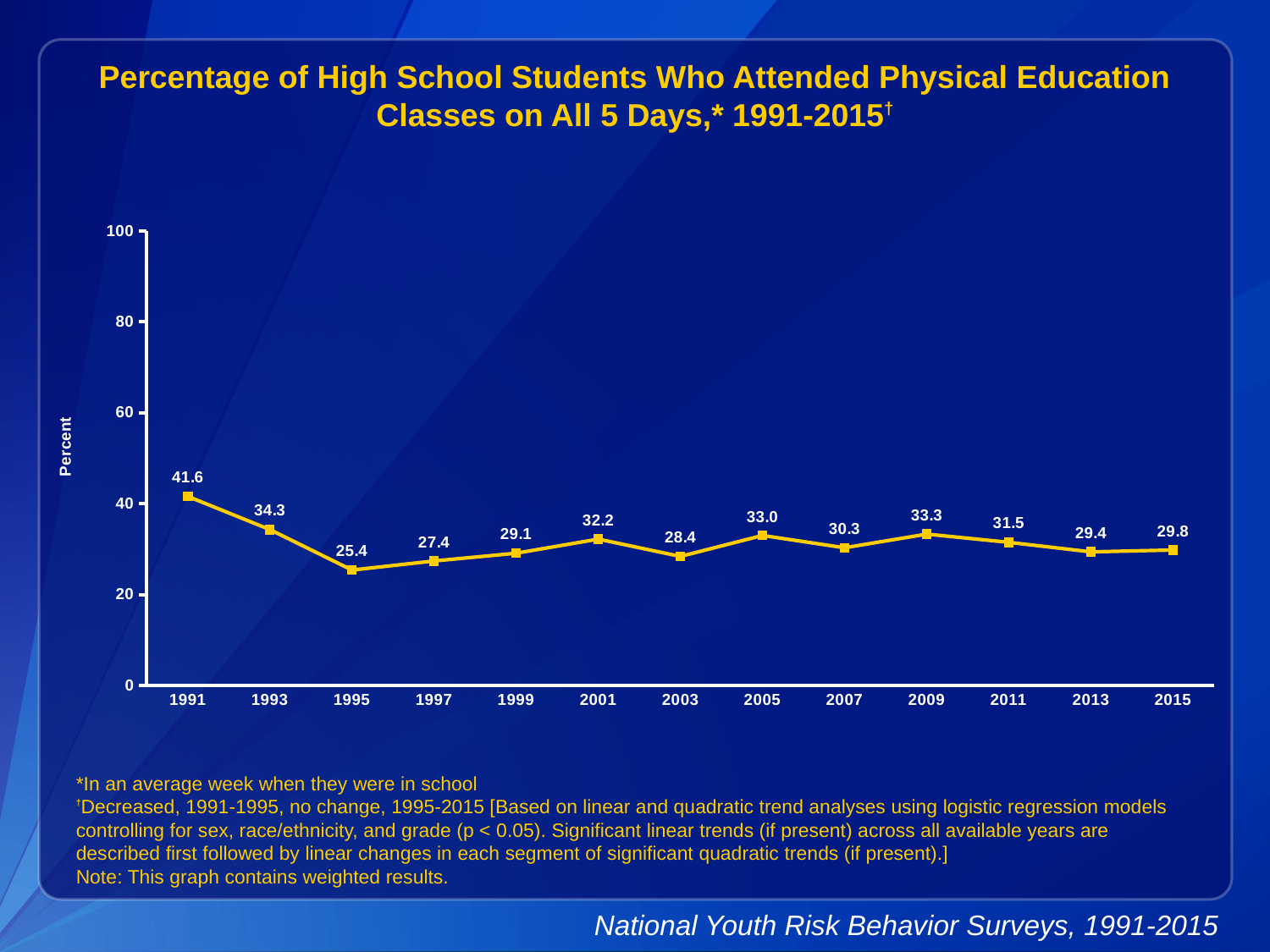
What is the difference between the 1991 value and the 1995 value? 16.2 Which year has the lowest percentage? 1995 Is the value for 1993 greater or less than 40? less What is the difference between the 2009 value and the 2015 value? 3.5 What kind of chart is shown on the slide? line chart How many years are plotted on the chart? 13 What percentage of high school students attended physical education classes on all 5 days in 1991? 41.6 What is the value shown for 2015? 29.8 Which year has a higher value, 2005 or 2007? 2005 Did the percentage rise or fall from 1991 to 1995? fall Which year has the highest percentage? 1991 What is the value shown for 2003? 28.4